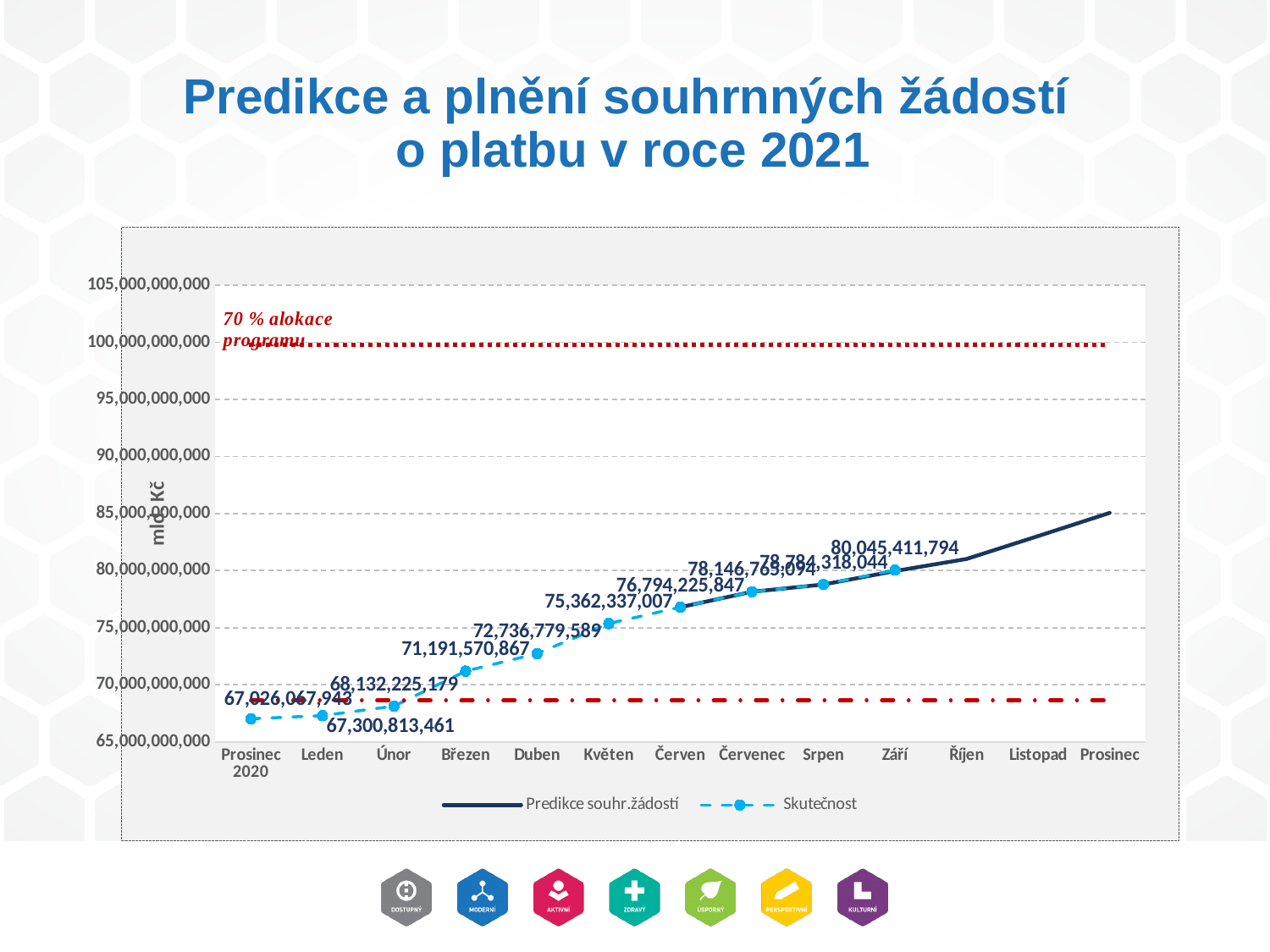
What kind of chart is shown on the slide? Line chart What is the Skutečnost value for Březen? 71,191,570,867 How many series does the legend list? 2 What is the Skutečnost value for Květen? 75,362,337,007 What is the Skutečnost value for Únor? 68,132,225,179 Is the Predikce souhr.žádostí value for Prosinec greater or less than 80,000,000,000? greater What is the Skutečnost value for Září? 80,045,411,794 How many categories are shown on the x axis? 13 What is the Skutečnost value for Prosinec 2020? 67,026,067,943 What is the difference between the Skutečnost values for Září and Prosinec 2020? 13,019,343,851 Do the Skutečnost values rise or fall from Prosinec 2020 to Září? Rise What label is attached to the red dotted line near 100,000,000,000? 70 % alokace programu